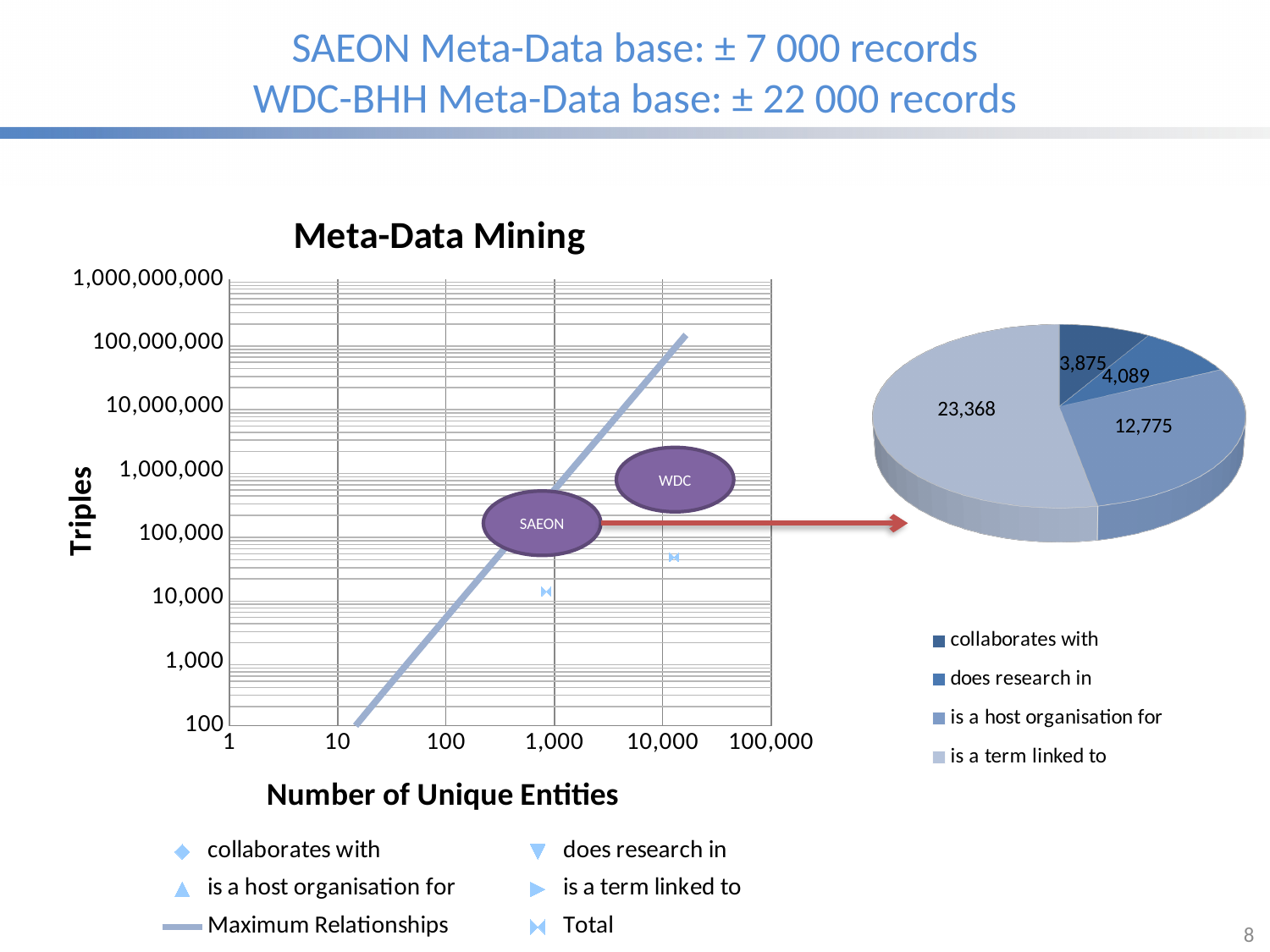
What type of chart is the 'Meta-Data Mining' chart on the left? Scatter chart How many slices does the pie chart on the right have? 4 In the pie chart on the right, what is the total of all four slice values? 44,107 In the pie chart on the right, what value is shown for the 'collaborates with' slice? 3,875 In the 'Meta-Data Mining' chart, what is the label of the y axis? Triples How many entries does the legend of the 'Meta-Data Mining' chart list? 6 In the pie chart on the right, which category has the largest slice? is a term linked to In the pie chart on the right, which category has the smallest slice? collaborates with In the pie chart on the right, what value is shown for the 'is a host organisation for' slice? 12,775 In the pie chart on the right, which is larger: 'does research in' or 'collaborates with'? does research in In the pie chart on the right, what is the difference between the 'is a term linked to' value and the 'is a host organisation for' value? 10,593 In the pie chart on the right, what value is shown for the 'is a term linked to' slice? 23,368